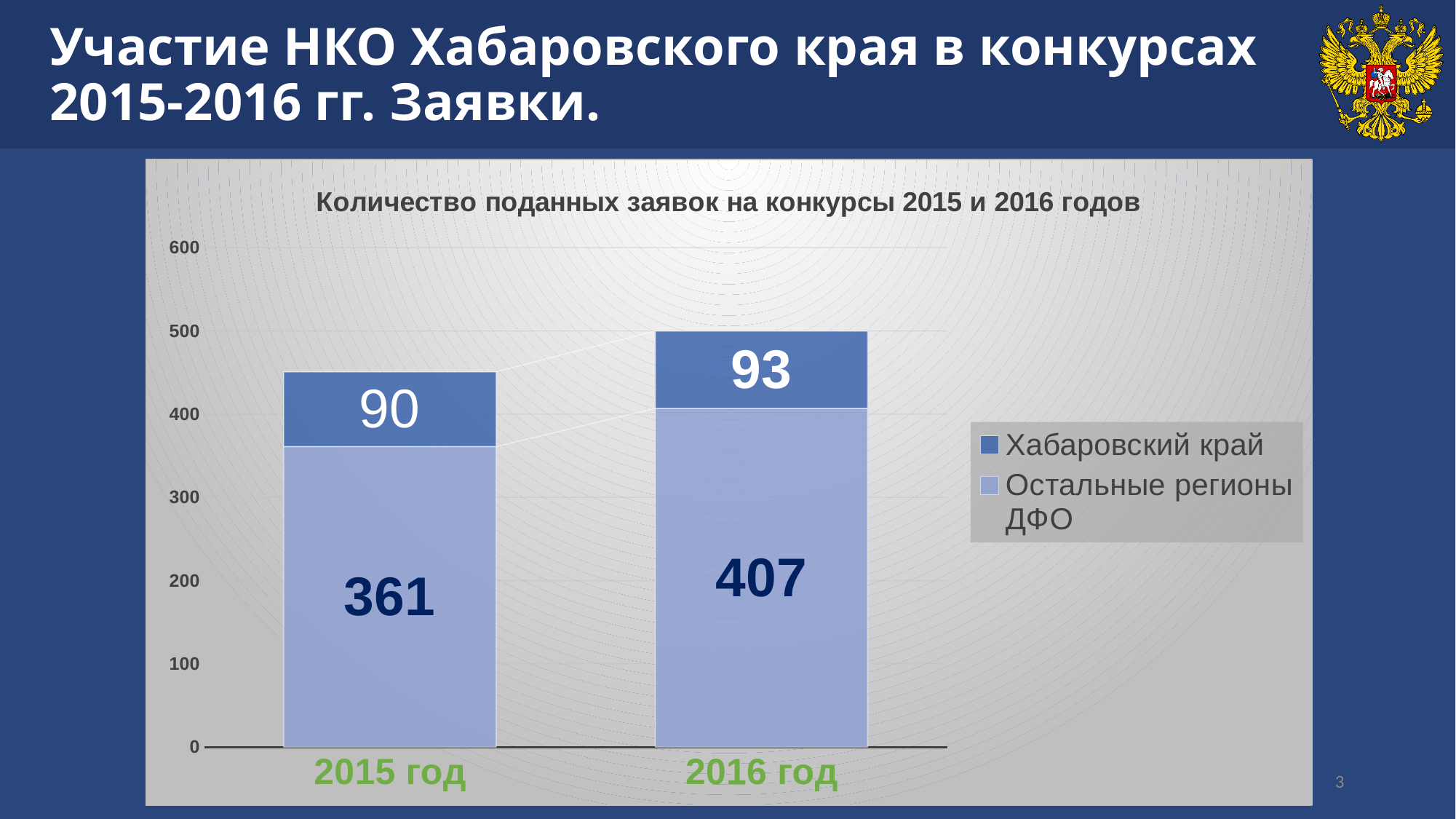
What is the value for Хабаровский край in 2016 год? 93 What is the value for Хабаровский край in 2015 год? 90 What is the value for Остальные регионы ДФО in 2016 год? 407 Which year has the larger value for Хабаровский край, 2015 год or 2016 год? 2016 год What is the total of the stacked bar for 2016 год? 500 What kind of chart is shown on the slide? Stacked bar chart How many categories are shown on the x axis? 2 What is the total of the stacked bar for 2015 год? 451 How many series does the legend list? 2 What is the difference between the Остальные регионы ДФО values for 2016 год and 2015 год? 46 What is the value for Остальные регионы ДФО in 2015 год? 361 What is the title of the chart? Количество поданных заявок на конкурсы 2015 и 2016 годов